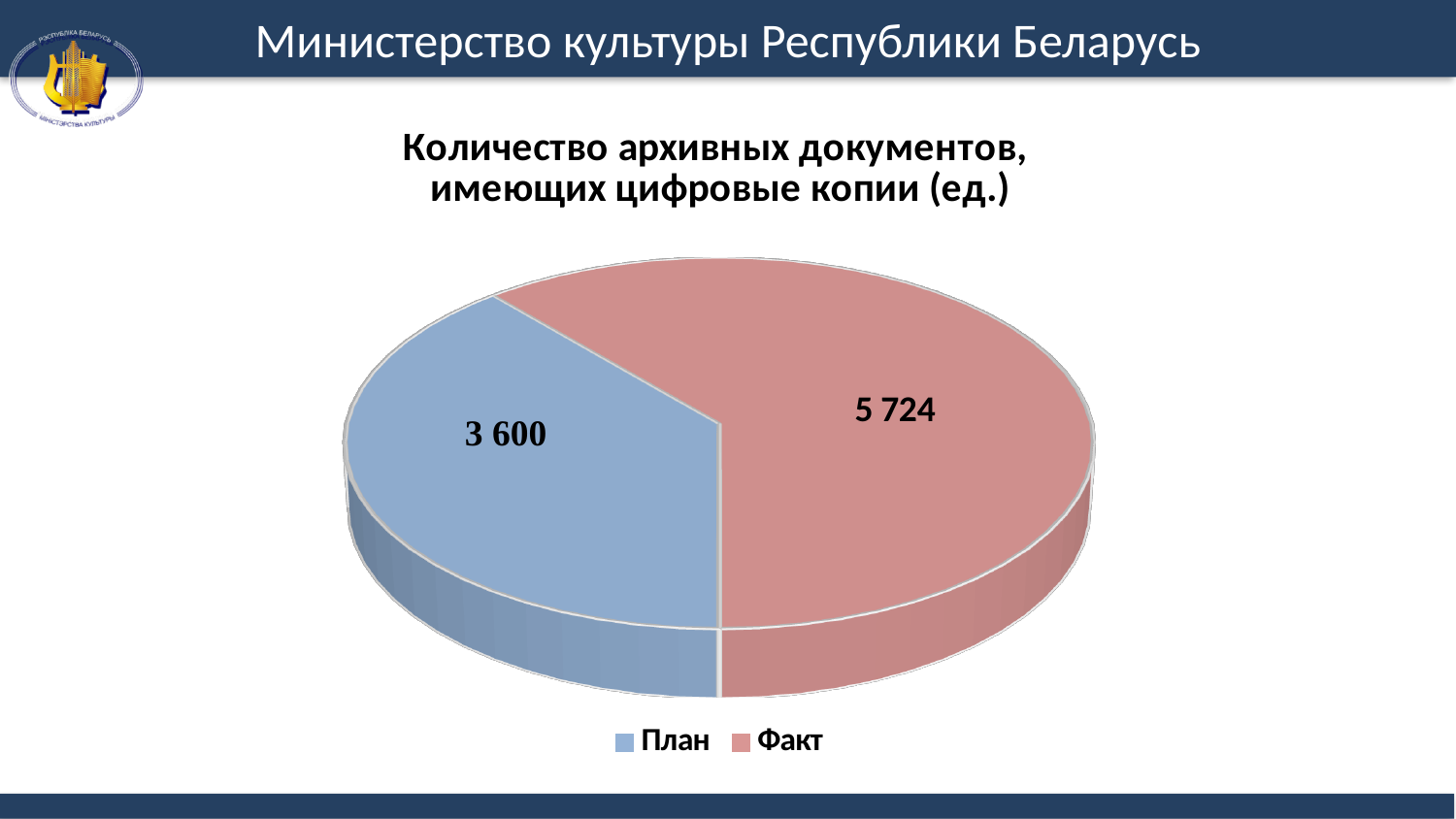
What is the value of the План slice? 3 600 How many slices does the pie chart have? 2 What colour is the План slice? Blue What kind of chart is shown on the slide? Pie chart Which slice is the smallest? План What is the difference between the Факт and План values? 2 124 What share of the pie does the Факт slice represent? 61.4% What is the title of the chart? Количество архивных документов, имеющих цифровые копии (ед.) Which slice is the largest? Факт Which is larger, План or Факт? Факт How many entries does the legend list? 2 What is the value of the Факт slice? 5 724